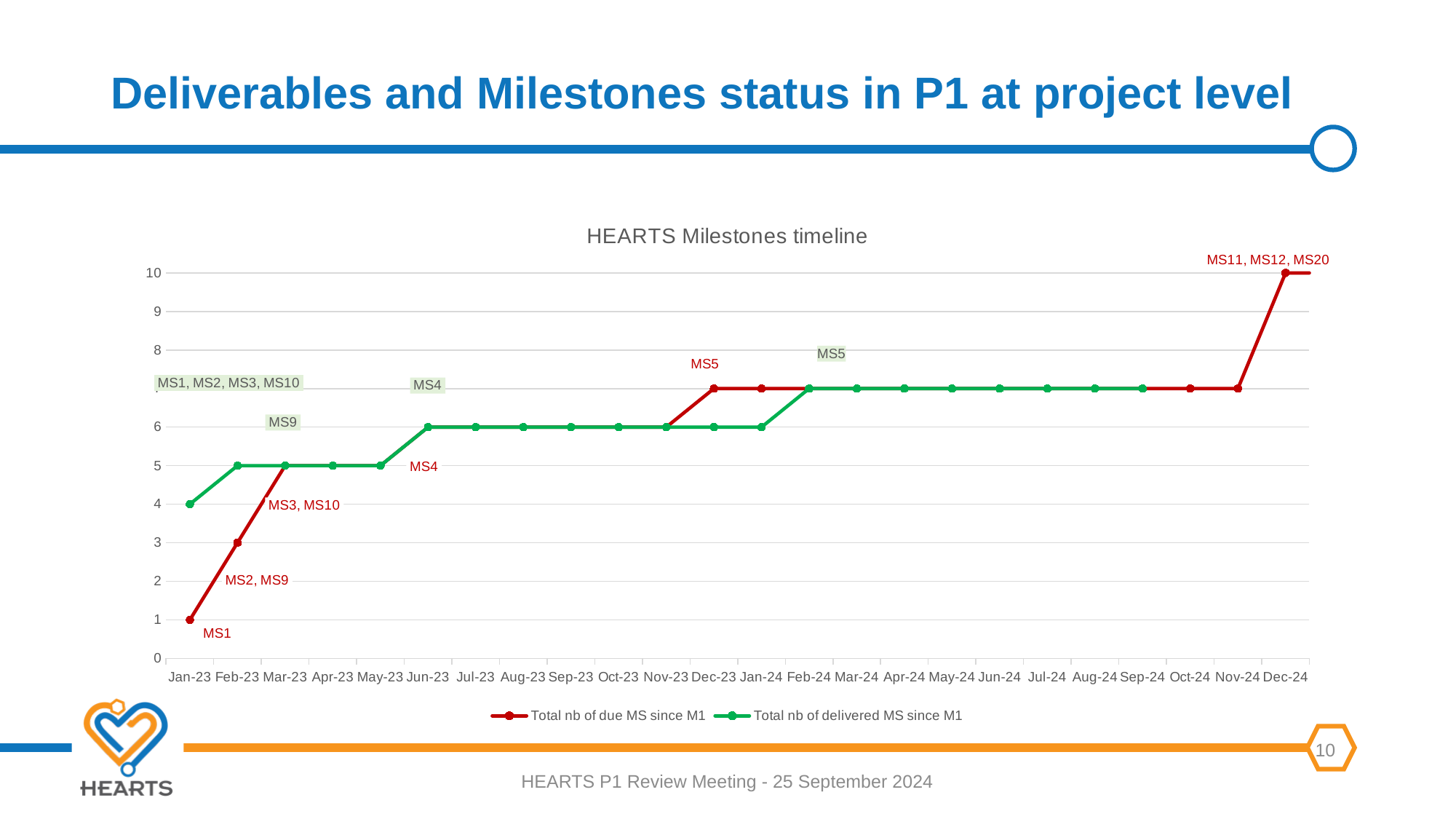
What is the value of 'Total nb of due MS since M1' at Mar-23? 5 How many series does the legend of the chart list? 2 At Jan-23, what is the difference between 'Total nb of delivered MS since M1' and 'Total nb of due MS since M1'? 3 What kind of chart is shown on the slide? line chart In which month does 'Total nb of due MS since M1' reach its highest value? Dec-24 What is the value of 'Total nb of delivered MS since M1' at Jun-23? 6 At Jan-23, which series has the larger value: 'Total nb of due MS since M1' or 'Total nb of delivered MS since M1'? Total nb of delivered MS since M1 What is the value of 'Total nb of due MS since M1' at Feb-23? 3 What is the value of 'Total nb of due MS since M1' at Jan-23? 1 What is the title of the chart? HEARTS Milestones timeline What is the value of 'Total nb of due MS since M1' at Dec-24? 10 What is the value of 'Total nb of delivered MS since M1' at Jan-23? 4